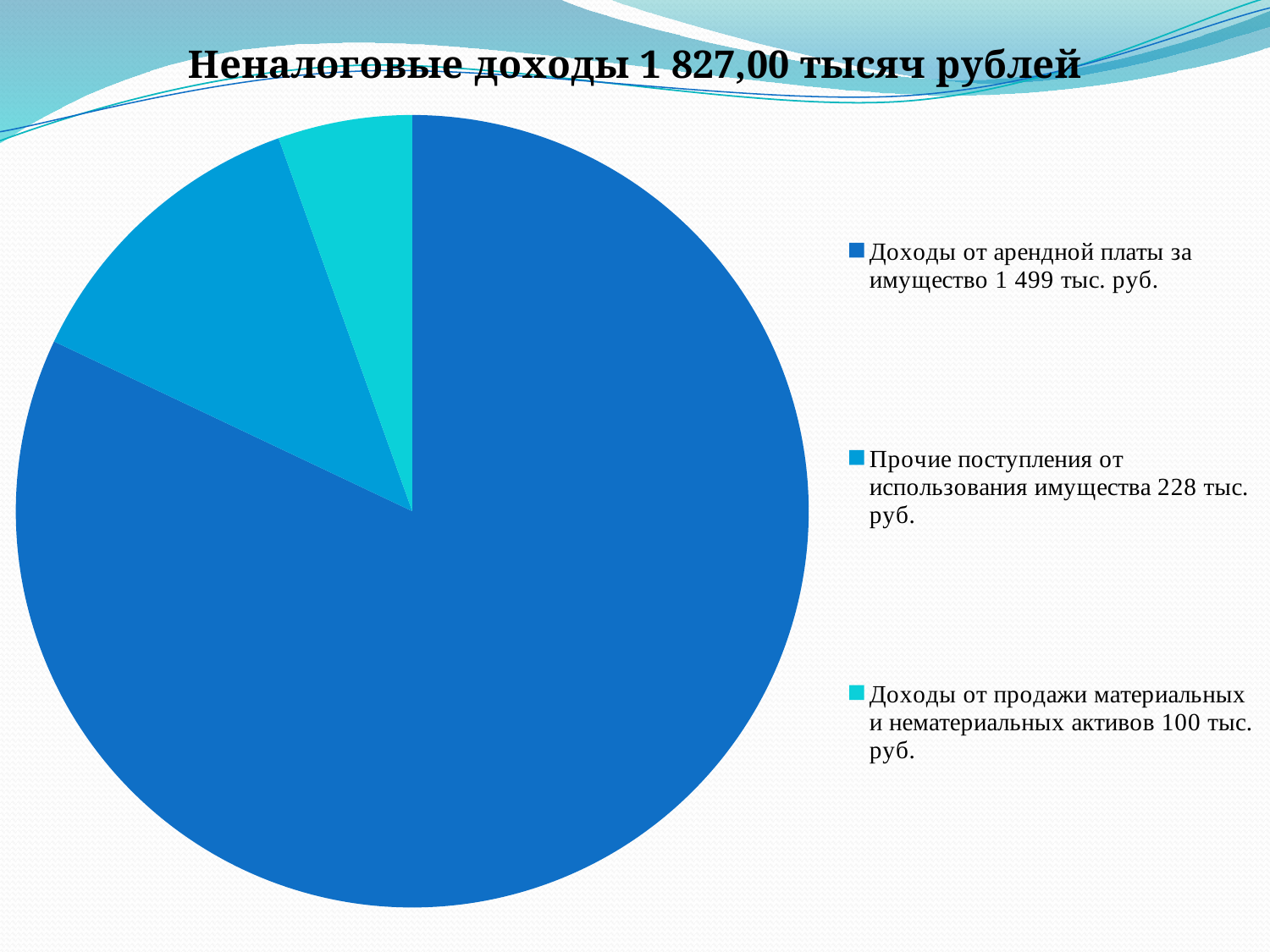
What type of chart is shown on the slide? Pie chart What is the difference between Доходы от арендной платы за имущество and Прочие поступления от использования имущества? 1 271 тыс. руб. What is the total of all three categories shown in the pie chart? 1 827 тыс. руб. What is the value for Доходы от продажи материальных и нематериальных активов? 100 тыс. руб. What is the value for Доходы от арендной платы за имущество? 1 499 тыс. руб. What is the value for Прочие поступления от использования имущества? 228 тыс. руб. Which category has the smallest slice of the pie? Доходы от продажи материальных и нематериальных активов Which category has the largest slice of the pie? Доходы от арендной платы за имущество How many slices does the pie chart have? 3 Which is larger: Прочие поступления от использования имущества or Доходы от продажи материальных и нематериальных активов? Прочие поступления от использования имущества What is the title of the chart? Неналоговые доходы 1 827,00 тысяч рублей How many entries does the legend list? 3